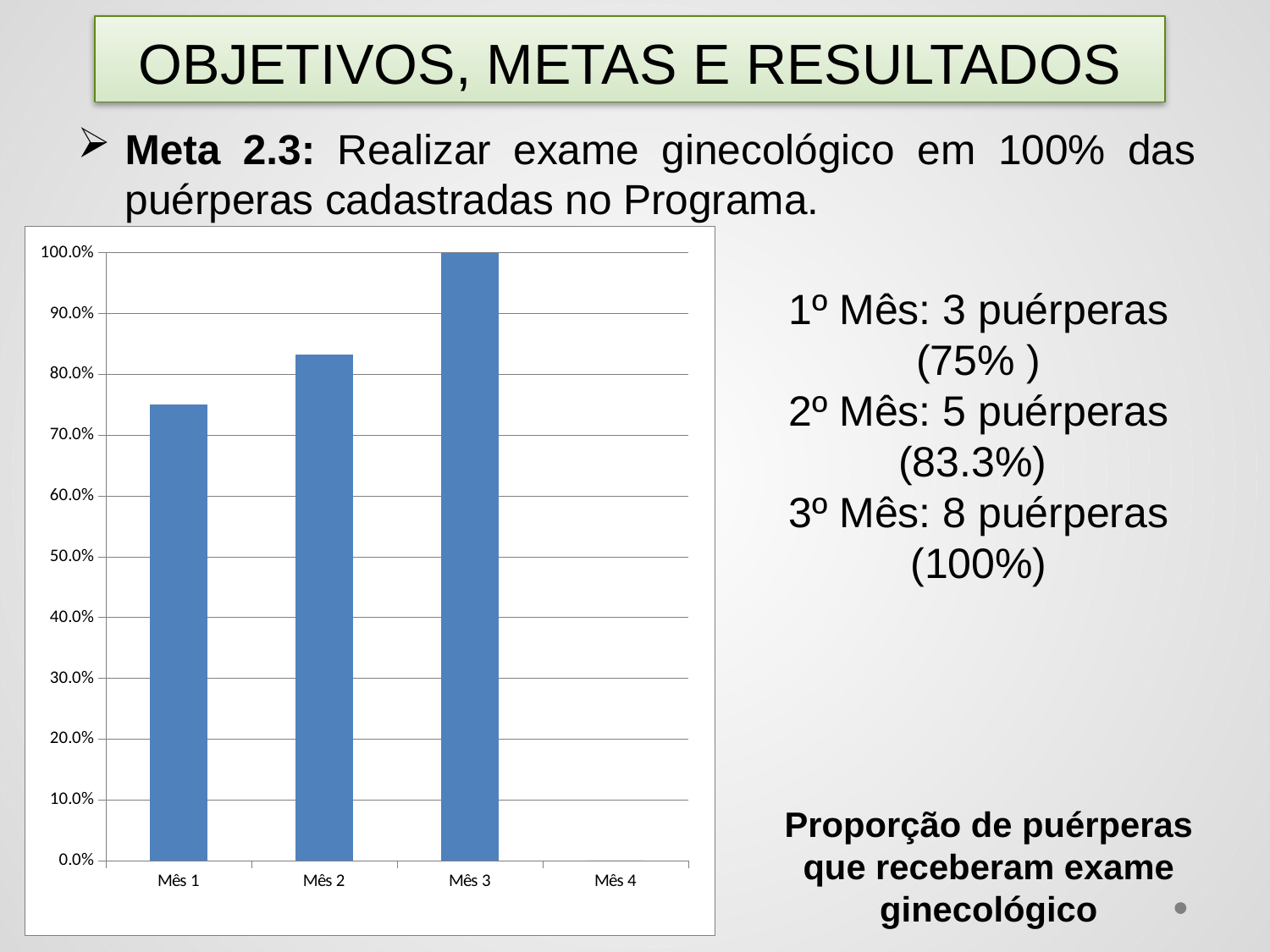
Is the value for Mês 2 greater or less than 90.0%? less Which month has the highest value? Mês 3 How many categories are shown on the x axis? 4 Is the value for Mês 1 greater or less than 70.0%? greater Is the value for Mês 1 greater or less than 80.0%? less Which month on the x axis has no bar plotted? Mês 4 What type of chart is shown on the slide? bar chart Which month has the shortest visible bar? Mês 1 Which is larger, the value for Mês 2 or the value for Mês 3? Mês 3 What is the value for Mês 3? 100.0% Do the values rise or fall from Mês 1 to Mês 3? rise